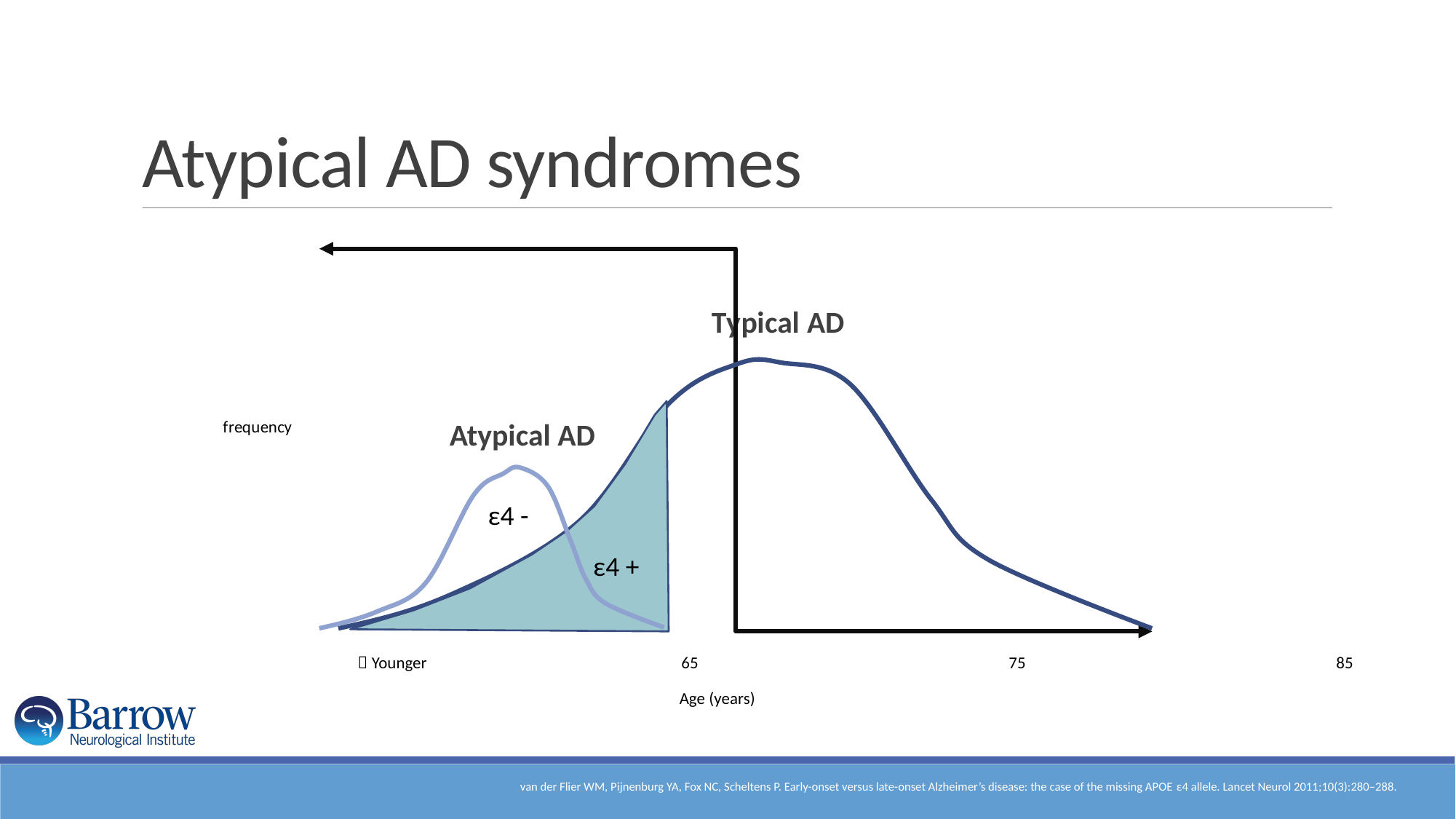
Does the Typical AD curve rise or fall between the Younger end of the axis and age 65? rise What is the label of the x axis of the chart? Age (years) Which curve reaches the higher peak frequency, Typical AD or Atypical AD? Typical AD What kind of chart is shown on the slide? Line chart Which curve peaks at a younger age, Typical AD or Atypical AD? Atypical AD What is the largest age value marked on the x axis? 85 Does the Typical AD curve peak at an age greater or less than 65? greater Does the Typical AD curve rise or fall between age 75 and age 85? fall Which curve peaks at an older age, Typical AD or Atypical AD? Typical AD What is the label of the y axis of the chart? frequency Does the Atypical AD curve peak at an age greater or less than 65? less How many curves are plotted on the chart? 2